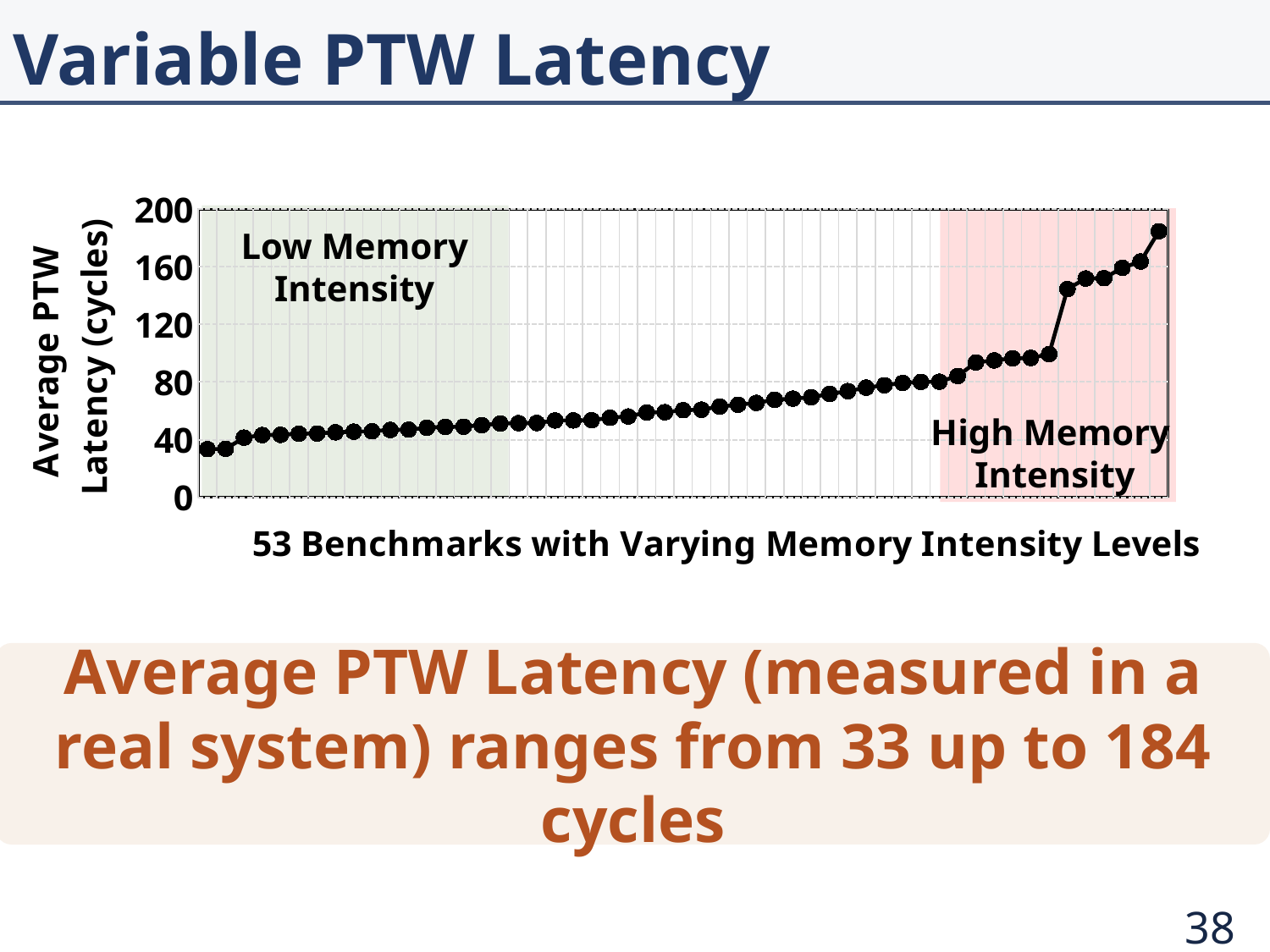
Is the value for the rightmost benchmark greater or less than 160? greater What is the lowest average PTW latency shown, according to the slide text? 33 cycles Is the value for the benchmark in the middle of the chart greater or less than 80? less How many benchmarks are plotted in the chart, according to the x-axis label? 53 What kind of chart is shown on the slide? line chart What is the highest average PTW latency shown, according to the slide text? 184 cycles Is the value for the leftmost benchmark greater or less than 40? less Which has the higher average PTW latency: the leftmost benchmark or the rightmost benchmark? the rightmost benchmark Do the plotted average PTW latency values rise or fall from left to right along the x axis? rise What is the label on the y axis of the chart? Average PTW Latency (cycles) What label is given to the shaded region on the right side of the chart? High Memory Intensity